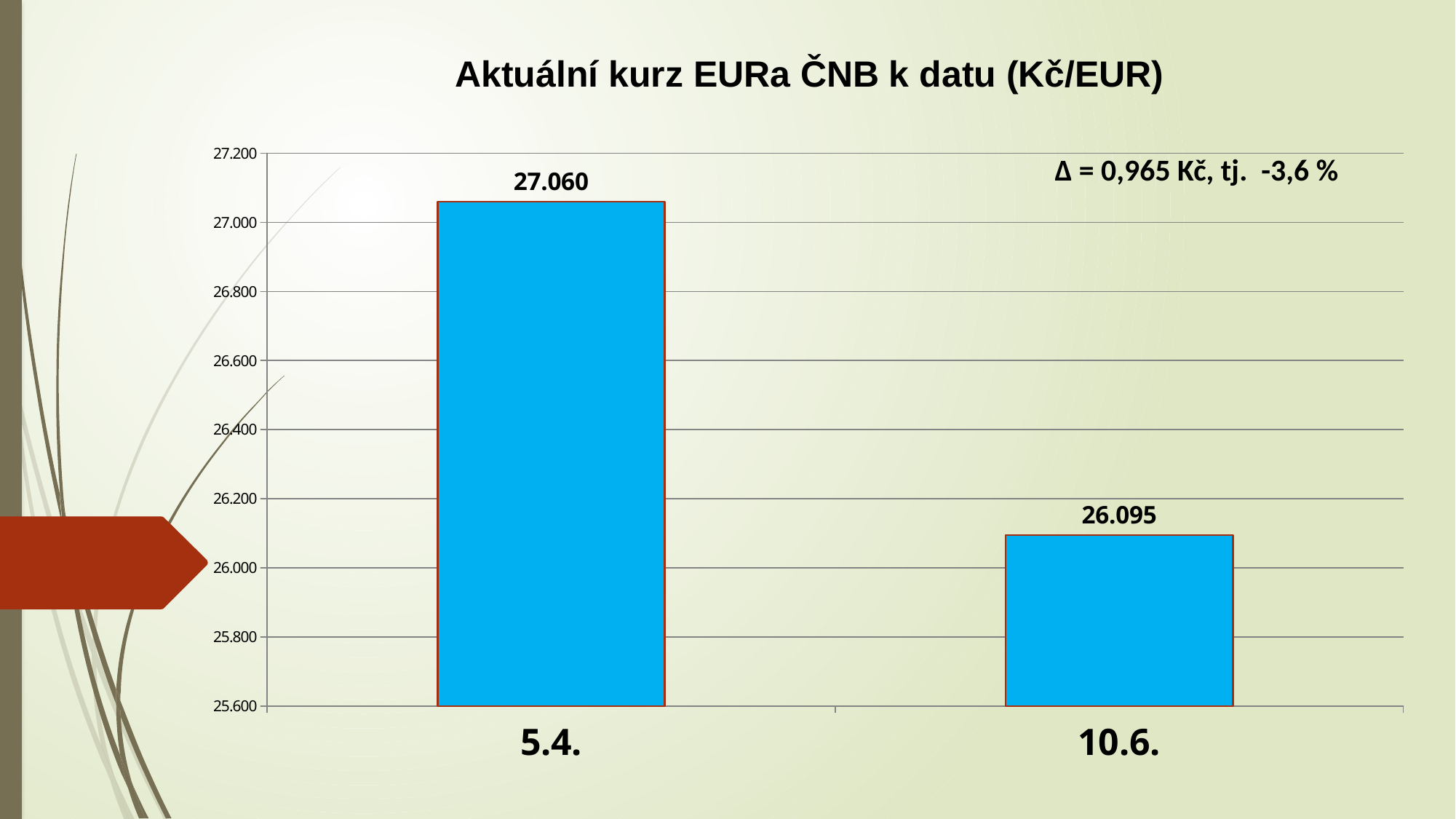
Which category has the lowest value? 10.6. What is the difference between the values for 5.4. and 10.6.? 0.965 Is the value for 5.4. greater or less than 27.000? greater Is the value for 10.6. greater or less than 26.200? less Do the values rise or fall from 5.4. to 10.6.? fall What is the title of the chart? Aktuální kurz EURa ČNB k datu (Kč/EUR) What is the value for 5.4.? 27.060 What kind of chart is shown on the slide? bar chart Which is larger, the value for 5.4. or the value for 10.6.? 5.4. How many categories are shown on the x axis? 2 What is the value for 10.6.? 26.095 Which category has the highest value? 5.4.